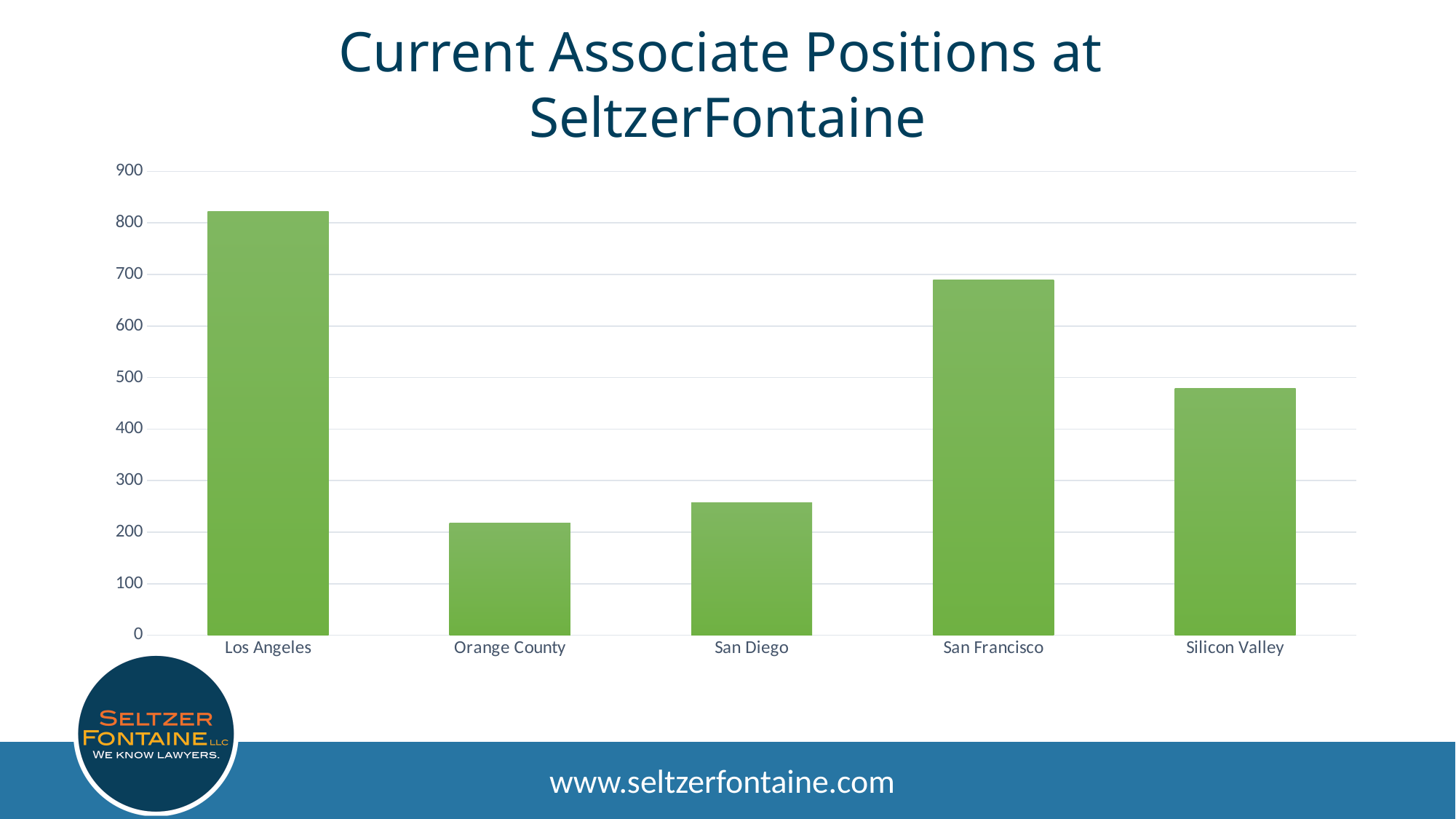
Which category has the lowest value in the chart? Orange County Is the value for San Francisco greater or less than 600? greater How many categories are shown on the x axis of the chart? 5 Which is larger, the value for San Francisco or the value for Silicon Valley? San Francisco Which category has the highest value in the chart? Los Angeles Is the value for San Diego greater or less than 300? less Is the value for Orange County greater or less than 300? less What is the title of the chart? Current Associate Positions at SeltzerFontaine Which is larger, the value for Los Angeles or the value for San Francisco? Los Angeles What type of chart is shown on the slide? bar chart